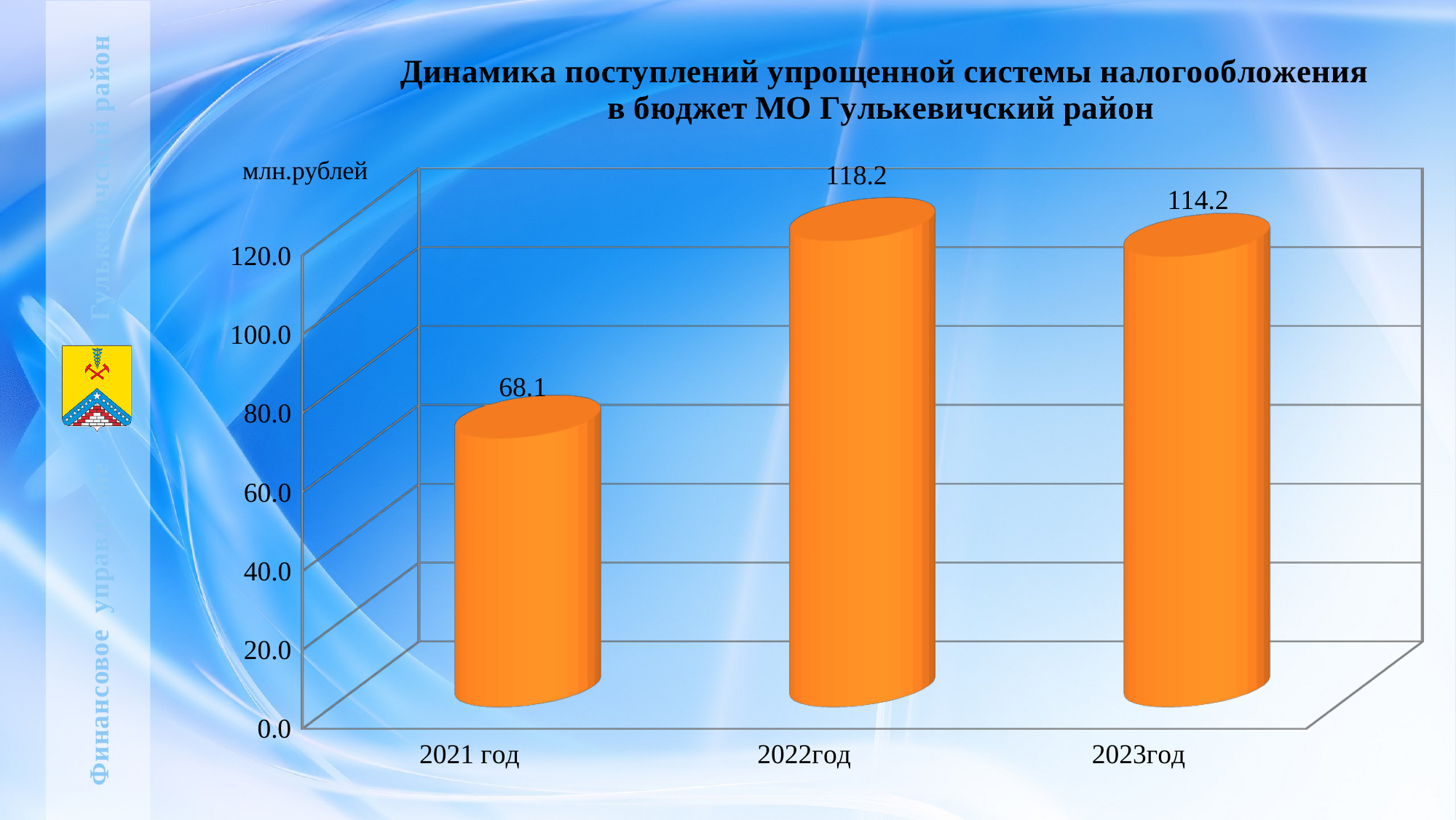
What is the difference between the values for 2022год and 2021 год? 50.1 What kind of chart is this? bar chart Is the value for 2021 год greater or less than 80.0? less Which year has the lowest value? 2021 год Which year has the highest value? 2022год Which is larger, the value for 2021 год or the value for 2023год? 2023год What is the difference between the values for 2022год and 2023год? 4.0 What is the value for 2021 год? 68.1 What unit is shown on the vertical axis label? млн.рублей What is the value for 2023год? 114.2 What is the value for 2022год? 118.2 How many years are shown on the chart? 3